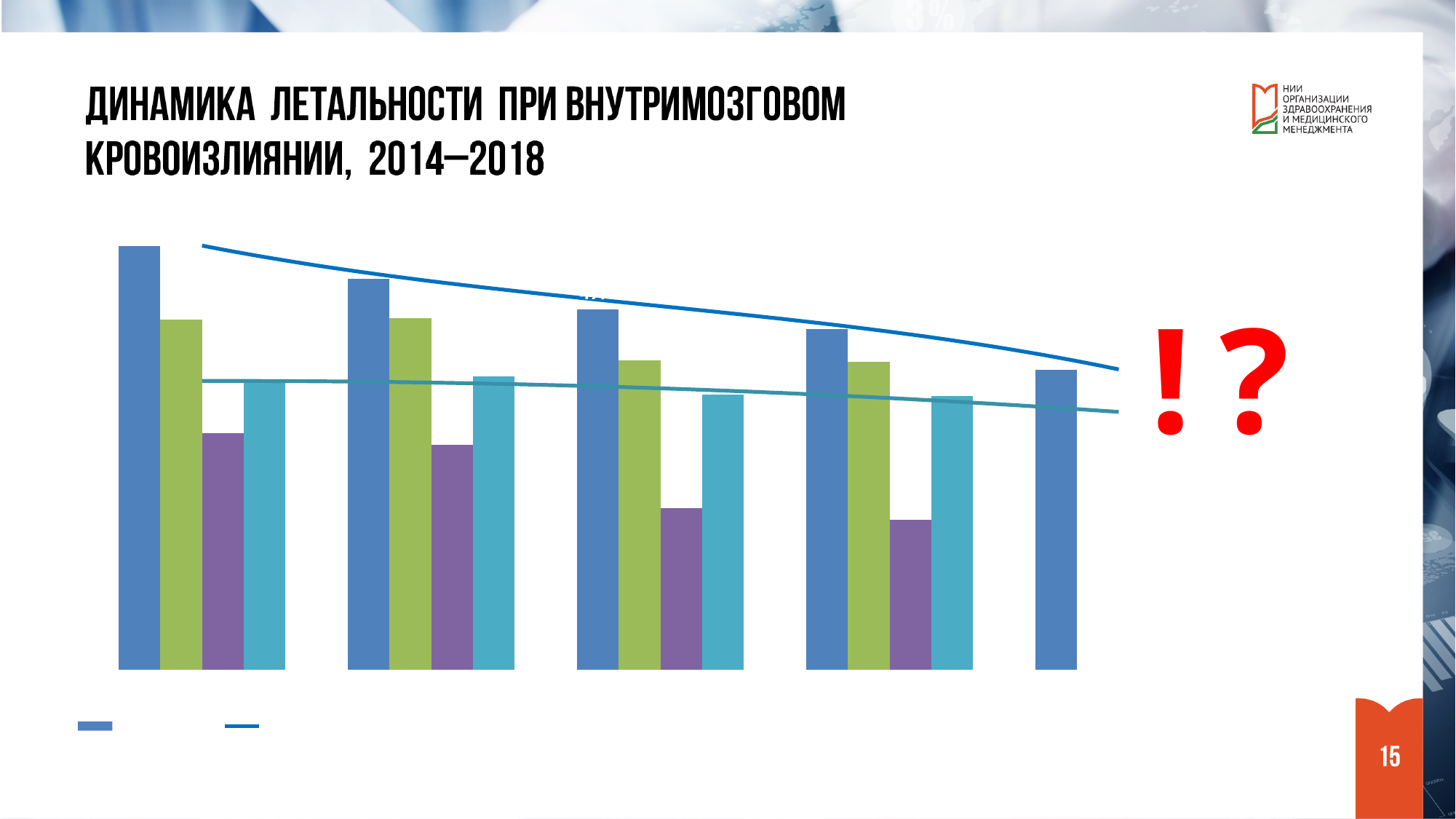
How many groups of bars are plotted along the x axis? 5 What kind of chart is shown on the slide? bar chart Do the purple bars rise or fall from left to right across the chart? fall In the first group of bars, is the dark blue bar or the purple bar taller? dark blue In the third group of bars, is the green bar or the purple bar taller? green How many trend lines are drawn over the bars? 2 Do the dark blue bars rise or fall from left to right across the chart? fall What is the title of the chart on the slide? Динамика летальности при внутримозговом кровоизлиянии, 2014–2018 Which colour bar is the shortest in the fourth group of bars? purple Which colour bar is the tallest in the first group of bars? dark blue